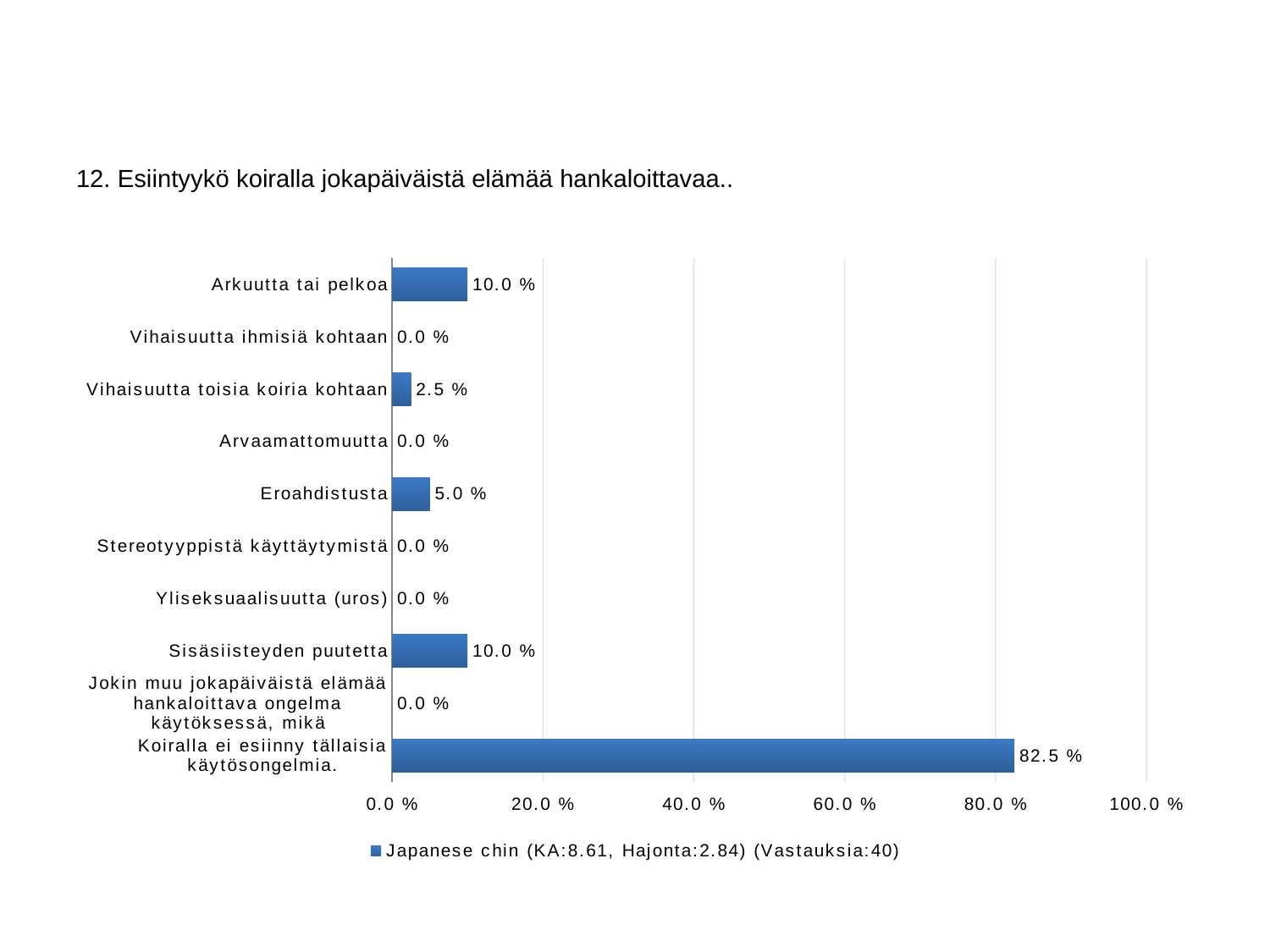
What is the difference between the values for Koiralla ei esiinny tällaisia käytösongelmia. and Arkuutta tai pelkoa? 72.5 % What is the value for Vihaisuutta toisia koiria kohtaan? 2.5 % What is the value for Koiralla ei esiinny tällaisia käytösongelmia.? 82.5 % What is the value for Eroahdistusta? 5.0 % What series does the legend list? Japanese chin (KA:8.61, Hajonta:2.84) (Vastauksia:40) Which category has the highest value? Koiralla ei esiinny tällaisia käytösongelmia. Which is larger, the value for Eroahdistusta or the value for Sisäsiisteyden puutetta? Sisäsiisteyden puutetta What is the difference between the values for Eroahdistusta and Vihaisuutta toisia koiria kohtaan? 2.5 % What kind of chart is shown on the slide? bar chart What is the value for Arkuutta tai pelkoa? 10.0 % Is the value for Koiralla ei esiinny tällaisia käytösongelmia. greater or less than 80.0 %? greater How many categories are shown on the chart? 10